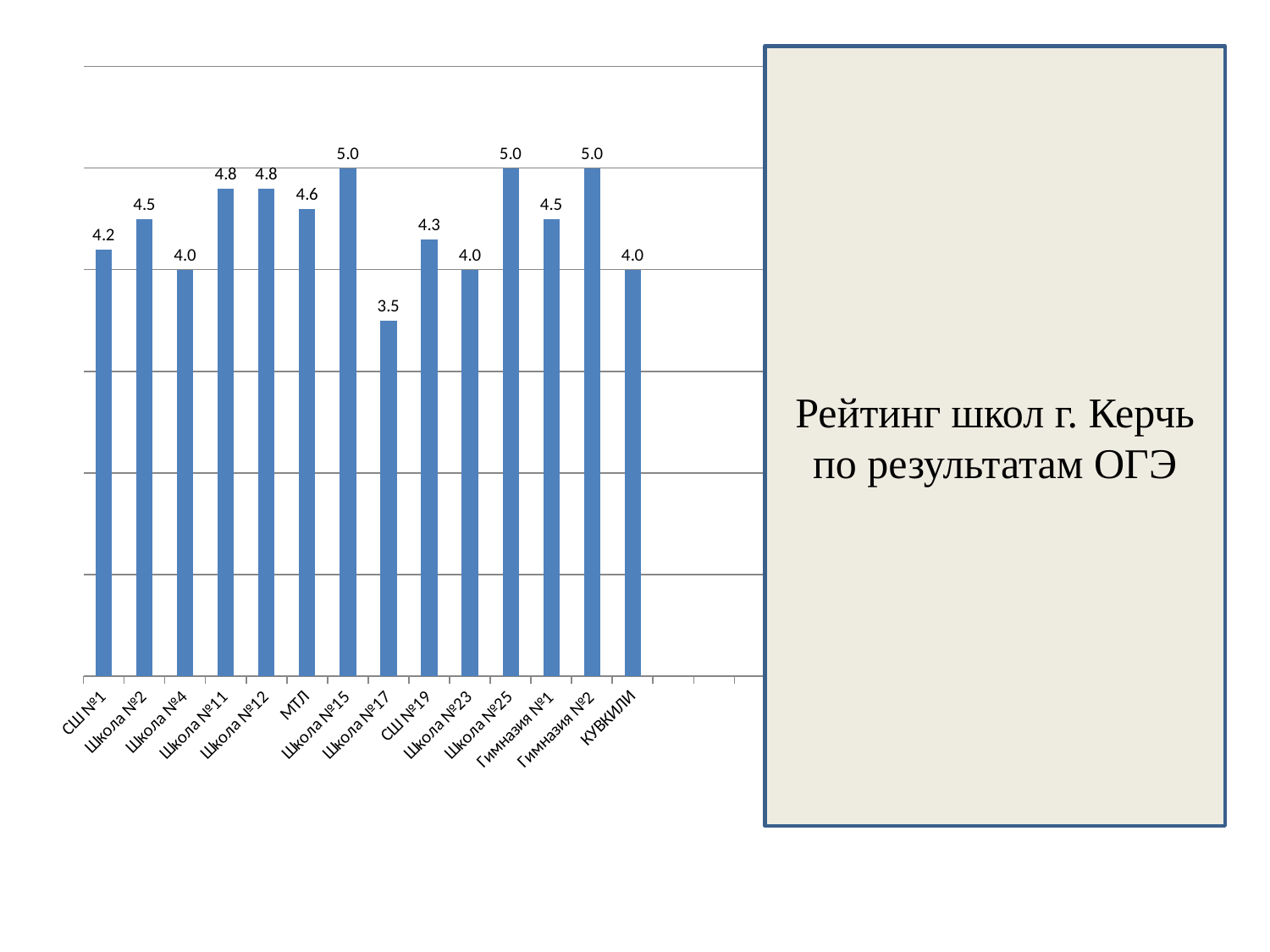
What is the difference between the values for Школа №15 and Школа №17? 1.5 What value is shown for Гимназия №1? 4.5 Which has a larger value, Школа №23 or Школа №25? Школа №25 How many schools are shown on the chart? 14 Which school has the lowest value on the chart? Школа №17 What is the difference between the values for Школа №11 and СШ №1? 0.6 What value is shown for МТЛ? 4.6 Which has a larger value, Школа №2 or Школа №4? Школа №2 What kind of chart is shown on the slide? Bar chart What value is shown for СШ №19? 4.3 What is the title text shown in the box next to the chart? Рейтинг школ г. Керчь по результатам ОГЭ What value is shown for Школа №17? 3.5